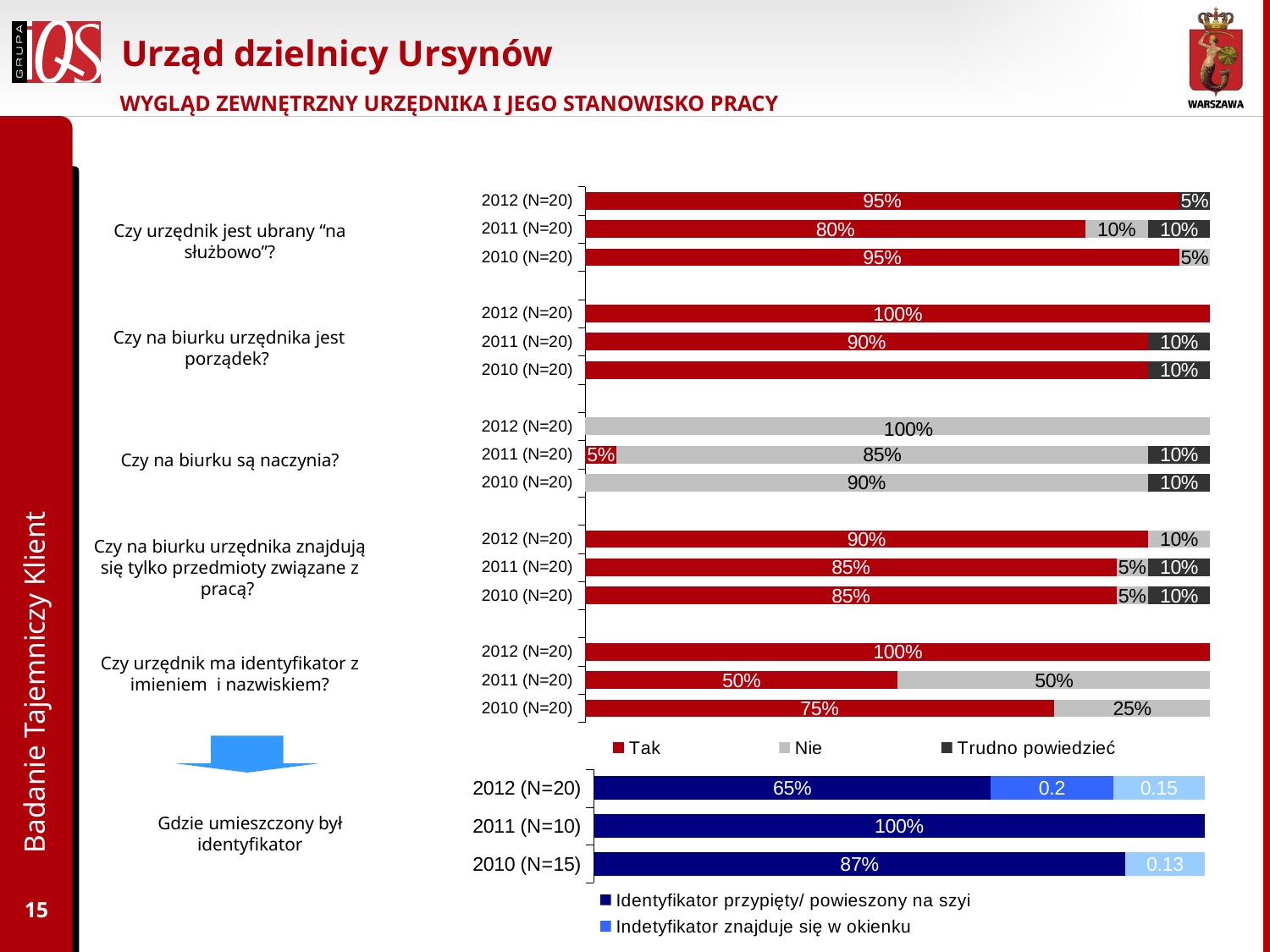
In the upper chart, for "Czy na biurku urzędnika jest porządek?", what is the "Tak" value for 2012 (N=20)? 100% In the upper chart, for "Czy na biurku są naczynia?", what is the "Tak" value for 2011 (N=20)? 5% How many year categories are shown in the lower chart ("Gdzie umieszczony był identyfikator")? 3 What kind of chart is the upper chart? Stacked bar chart In the upper chart, for "Czy urzędnik jest ubrany "na służbowo"?", which year has the larger "Tak" value, 2012 (N=20) or 2011 (N=20)? 2012 (N=20) In the lower chart ("Gdzie umieszczony był identyfikator"), what is the value for "Identyfikator przypięty/ powieszony na szyi" in 2011 (N=10)? 100% How many series does the legend of the upper chart list? 3 In the lower chart ("Gdzie umieszczony był identyfikator"), which year has the highest value for "Identyfikator przypięty/ powieszony na szyi"? 2011 (N=10) In the upper chart, for "Czy urzędnik ma identyfikator z imieniem i nazwiskiem?", what is the difference between the "Tak" values for 2010 (N=20) and 2011 (N=20)? 25 percentage points In the upper chart, for "Czy urzędnik ma identyfikator z imieniem i nazwiskiem?", what is the "Nie" value for 2010 (N=20)? 25% In the upper chart, for "Czy urzędnik jest ubrany "na służbowo"?", what is the "Tak" value for 2011 (N=20)? 80% In the lower chart ("Gdzie umieszczony był identyfikator"), what is the value for "Identyfikator przypięty/ powieszony na szyi" in 2012 (N=20)? 65%